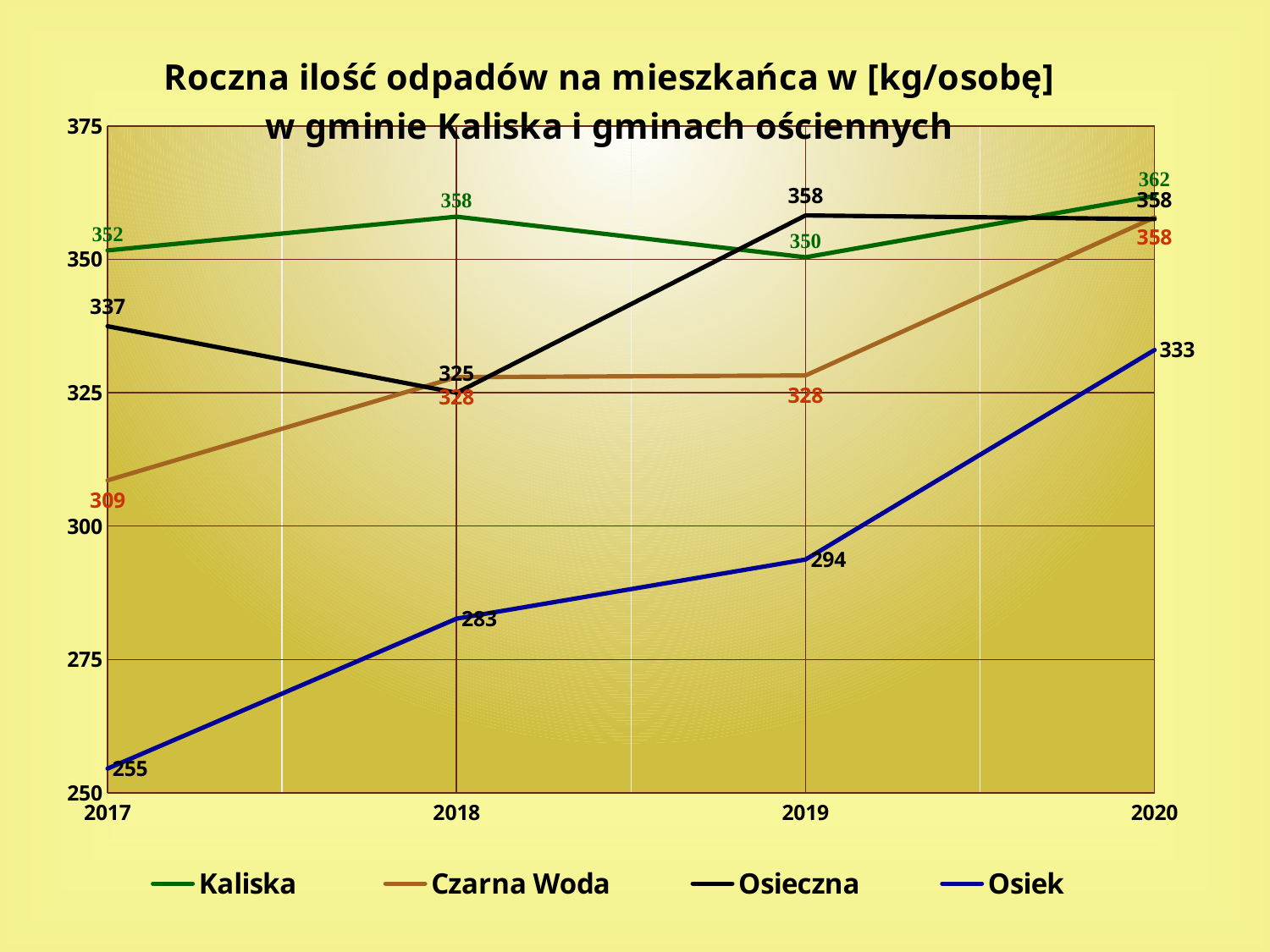
Which series has the highest value in 2018? Kaliska Which series has the lowest value in 2017? Osiek What is the difference between the Osiek values in 2020 and 2017? 78 How many series does the legend list? 4 What is the value for Czarna Woda in 2018? 328 What is the value for Osiek in 2017? 255 What kind of chart is shown on the slide? line chart How many years are shown on the x axis? 4 Does the Osiek series rise or fall from 2017 to 2020? rise What is the value for Osieczna in 2019? 358 Which is larger in 2019: the value for Kaliska or the value for Osieczna? Osieczna What is the value for Kaliska in 2020? 362